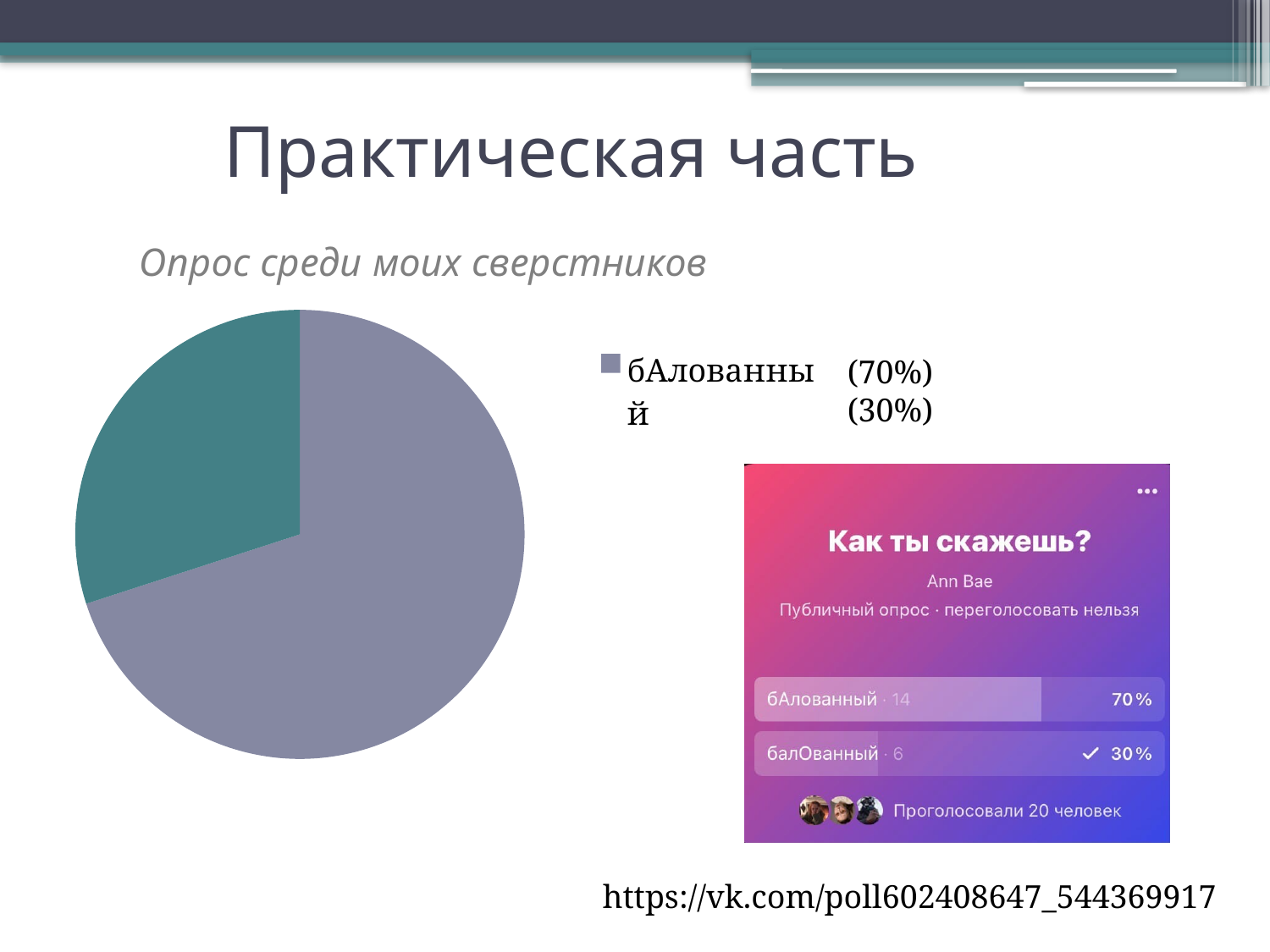
Which slice of the pie chart is larger, the grey-purple one or the teal one? the grey-purple one Is the share of the teal slice greater or less than 50%? less What colour is the slice for бАлованный in the pie chart? grey-purple Which category has the largest share in the pie chart? бАлованный What is the difference in percentage points between the two slices of the pie chart? 40 percentage points What is the subtitle written above the pie chart? Опрос среди моих сверстников Is the share of the бАлованный slice greater or less than 50%? greater How many slices does the pie chart have? 2 What share of the pie does the smaller (teal) slice represent? 30% What kind of chart is shown on the slide? pie chart What share of the pie does the бАлованный slice represent? 70%